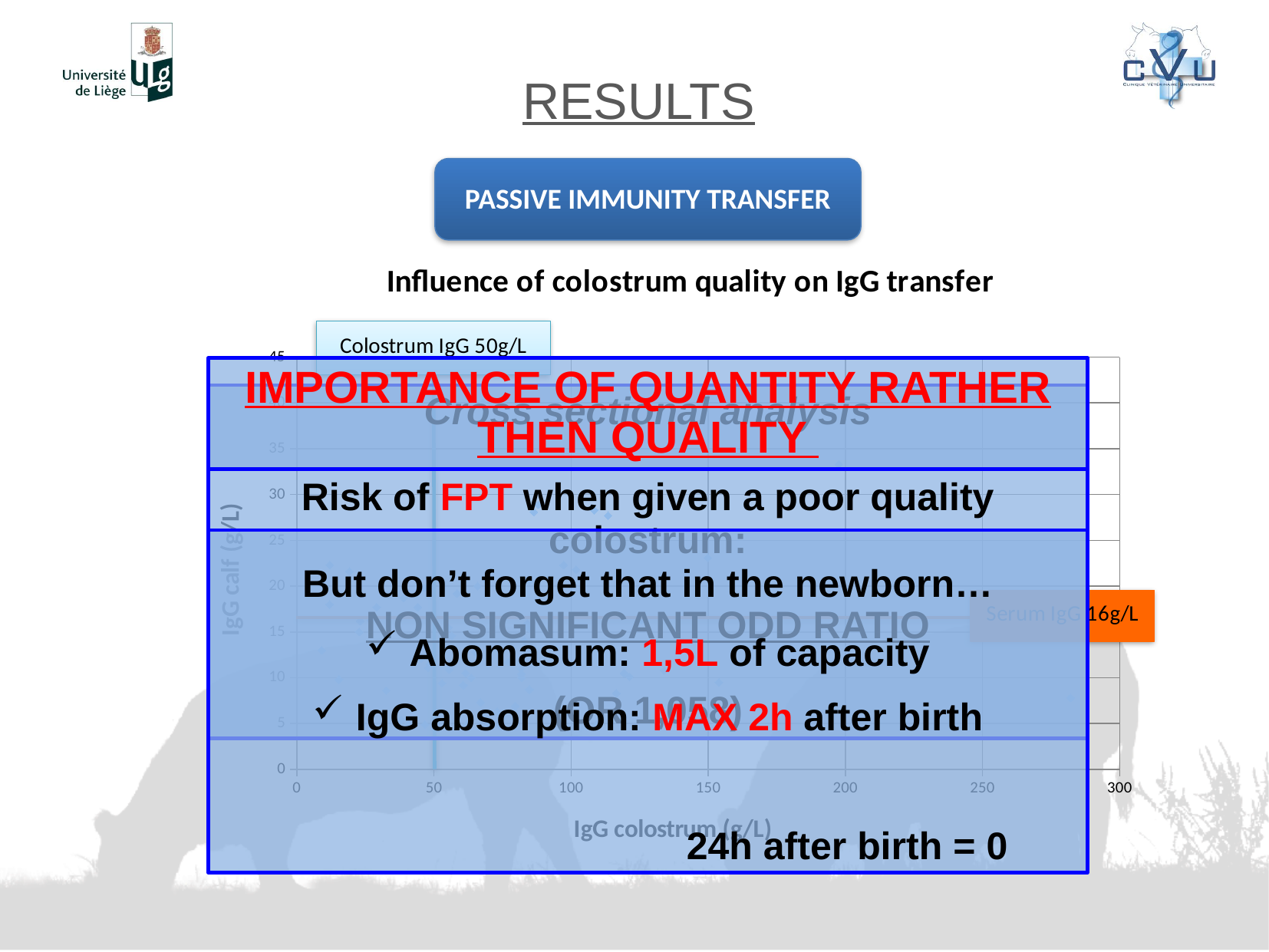
What serum IgG value is marked by the horizontal reference line annotation on the chart? 16g/L What is the label of the x axis of the chart? IgG colostrum (g/L) What is the highest tick value shown on the y axis of the chart? 45 What colostrum IgG value is marked by the vertical reference line annotation on the chart? 50g/L What is the highest tick value shown on the x axis of the chart? 300 What is the title of the chart on the slide? Influence of colostrum quality on IgG transfer